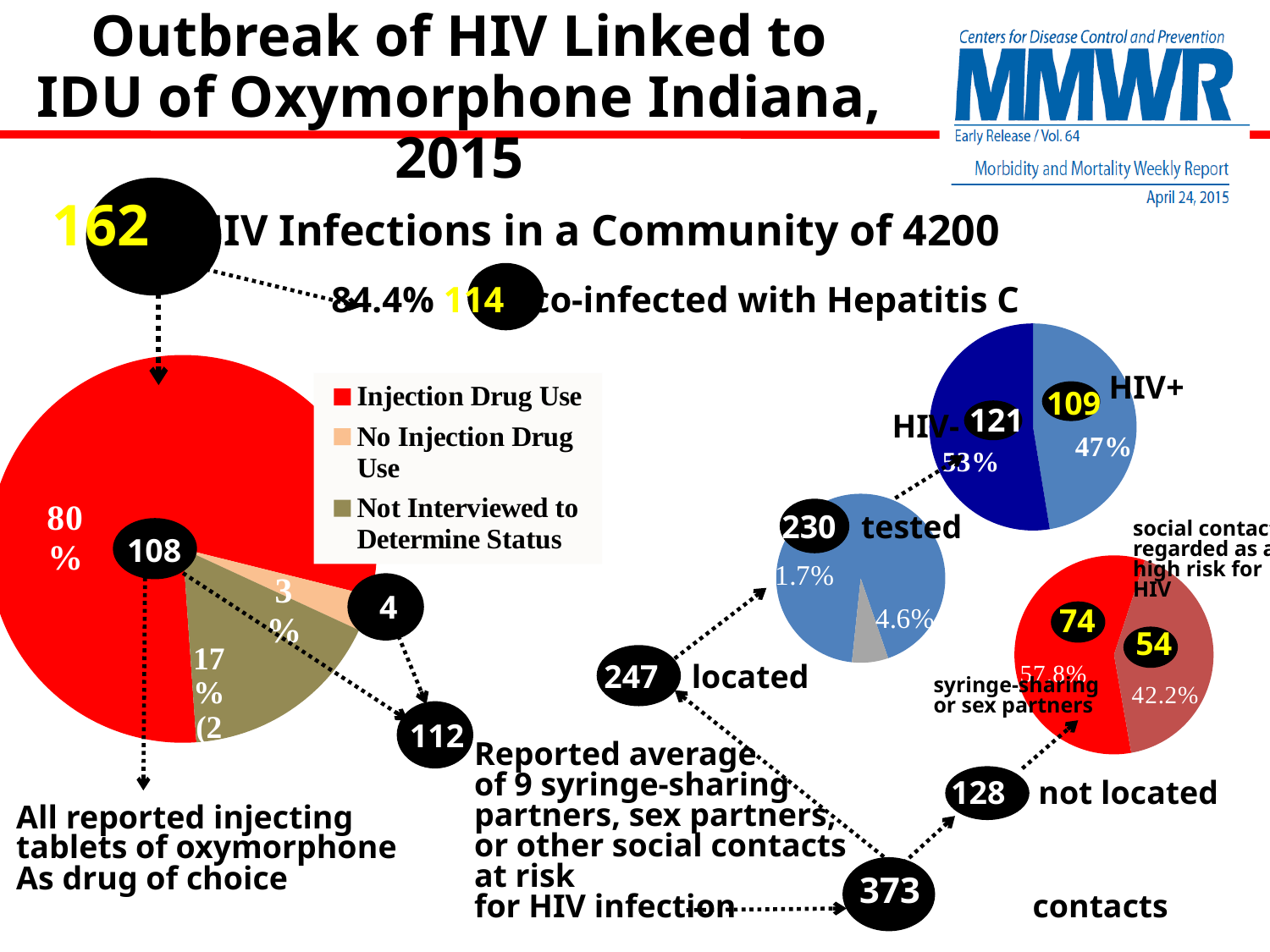
In the left pie chart, what percentage is shown for Injection Drug Use? 80% In the top-right pie chart showing HIV- and HIV+, which slice is larger, HIV- or HIV+? HIV- What kind of chart is the large chart on the left of the slide with the Injection Drug Use legend? pie chart In the left pie chart, what percentage is shown for Not Interviewed to Determine Status? 17% In the bottom-right pie chart, what is the difference in percentage points between the 57.8% slice and the 42.2% slice? 15.6 percentage points In the left pie chart, how many entries does the legend list? 3 In the left pie chart, which category has the smallest share? No Injection Drug Use In the left pie chart, what percentage is shown for No Injection Drug Use? 3% In the left pie chart, which category has the largest share? Injection Drug Use In the top-right pie chart showing HIV- and HIV+, what is the difference in percentage points between the HIV- share and the HIV+ share? 6 percentage points In the top-right pie chart showing HIV- and HIV+, what percentage is shown for HIV+? 47% In the bottom-right pie chart, what percentage is shown for syringe-sharing or sex partners? 57.8%